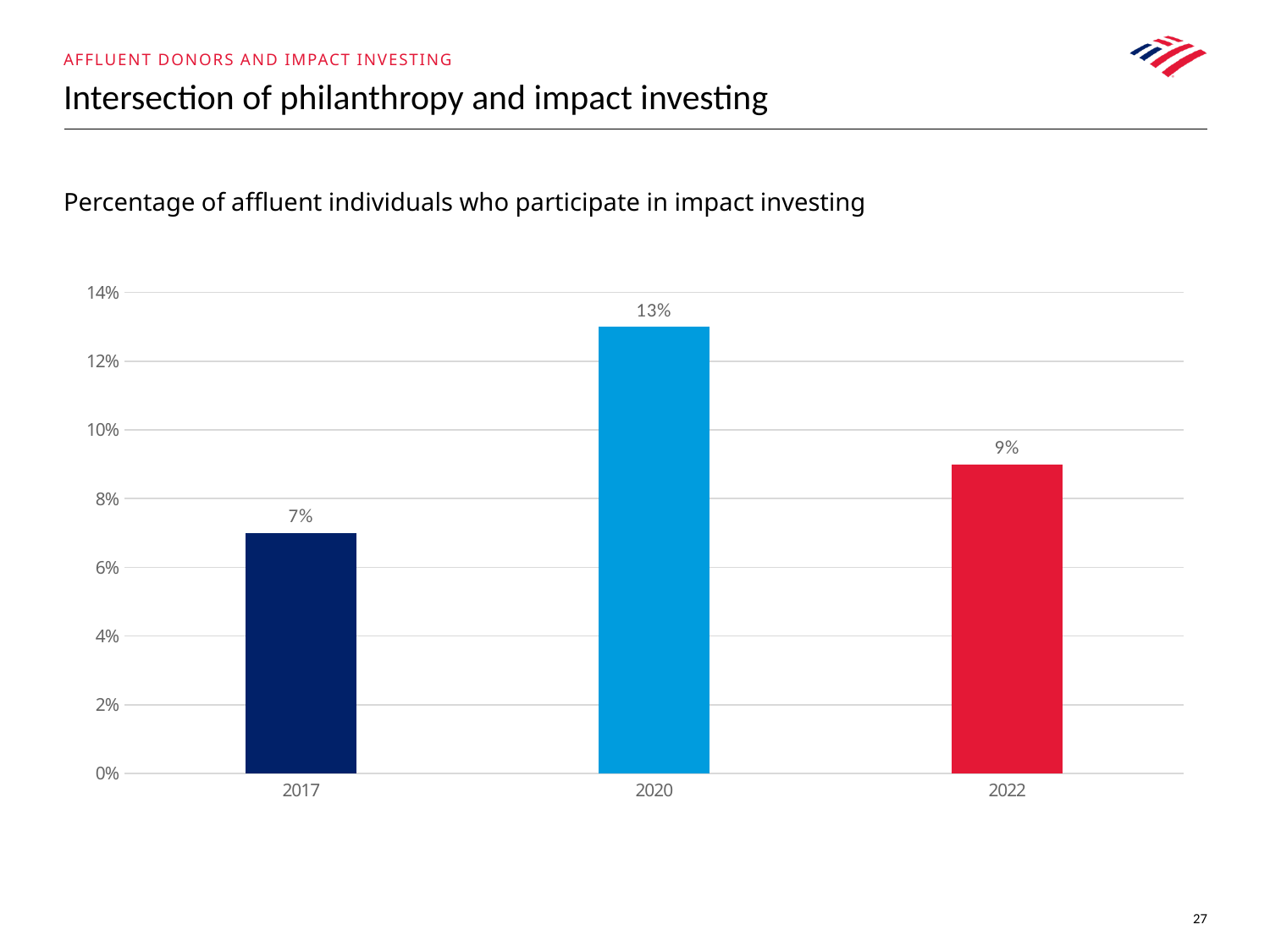
What kind of chart is shown on the slide? Bar chart What is the difference in percentage points between 2022 and 2017? 2 percentage points What percentage of affluent individuals participated in impact investing in 2017? 7% What is the difference in percentage points between 2020 and 2022? 4 percentage points What percentage of affluent individuals participated in impact investing in 2022? 9% How many years are shown on the x axis of the chart? 3 Which year has the lowest percentage of affluent individuals participating in impact investing? 2017 Which year has the highest percentage of affluent individuals participating in impact investing? 2020 Is the value for 2020 greater or less than 12%? greater Which year has a larger value, 2017 or 2022? 2022 What percentage of affluent individuals participated in impact investing in 2020? 13% What is the title of the chart on the slide? Percentage of affluent individuals who participate in impact investing